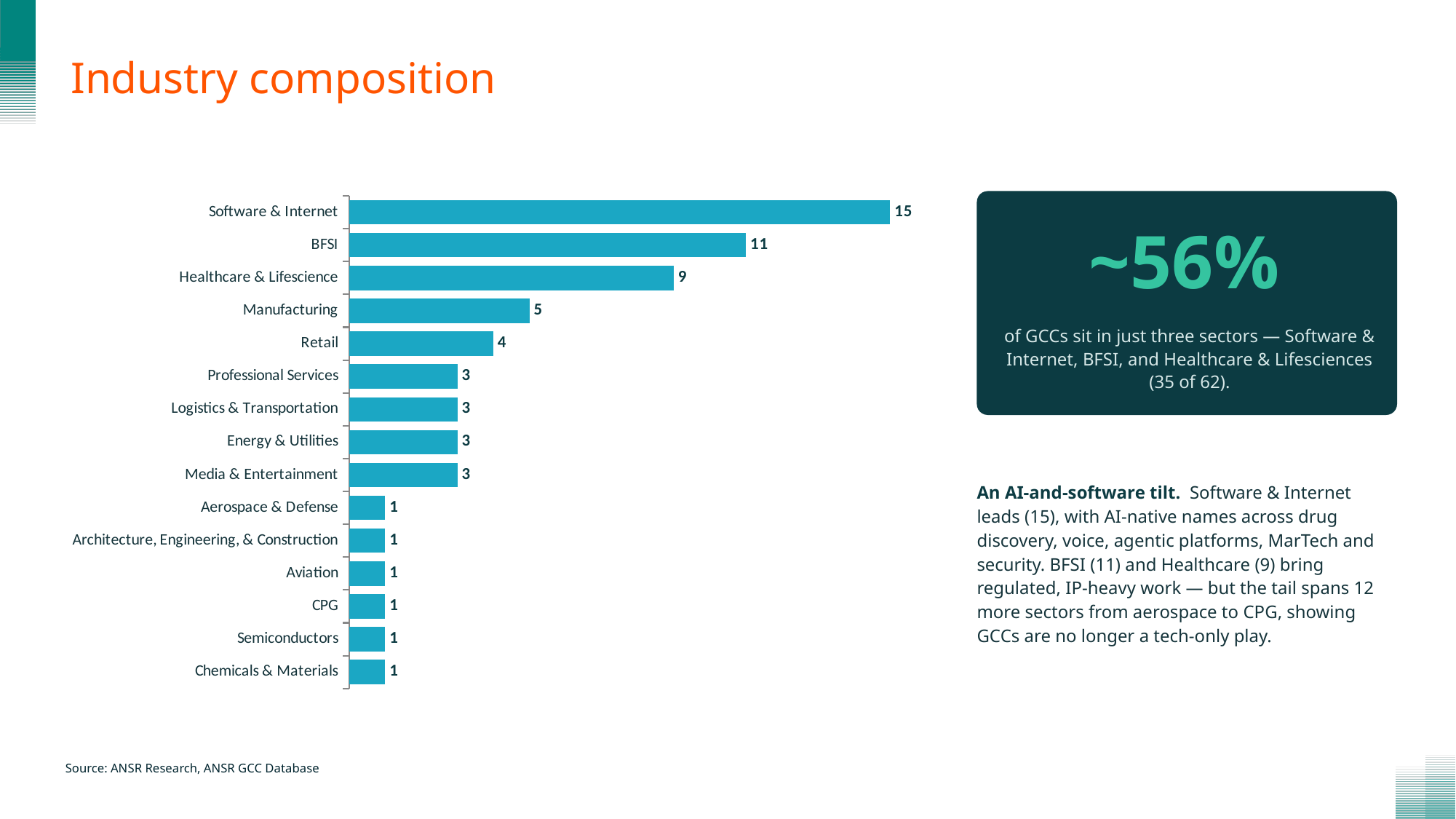
What is the difference between the values for Software & Internet and BFSI? 4 What is the difference between the values for Manufacturing and Retail? 1 What is the title of the slide containing the chart? Industry composition What is the value for Healthcare & Lifescience? 9 Which category has the highest value? Software & Internet What is the value for BFSI? 11 How many categories are shown in the chart? 15 What kind of chart is shown on the slide? Bar chart How many categories have a value of 1? 6 Which is larger, the value for Manufacturing or the value for Professional Services? Manufacturing What is the value for Retail? 4 What is the value for Software & Internet? 15